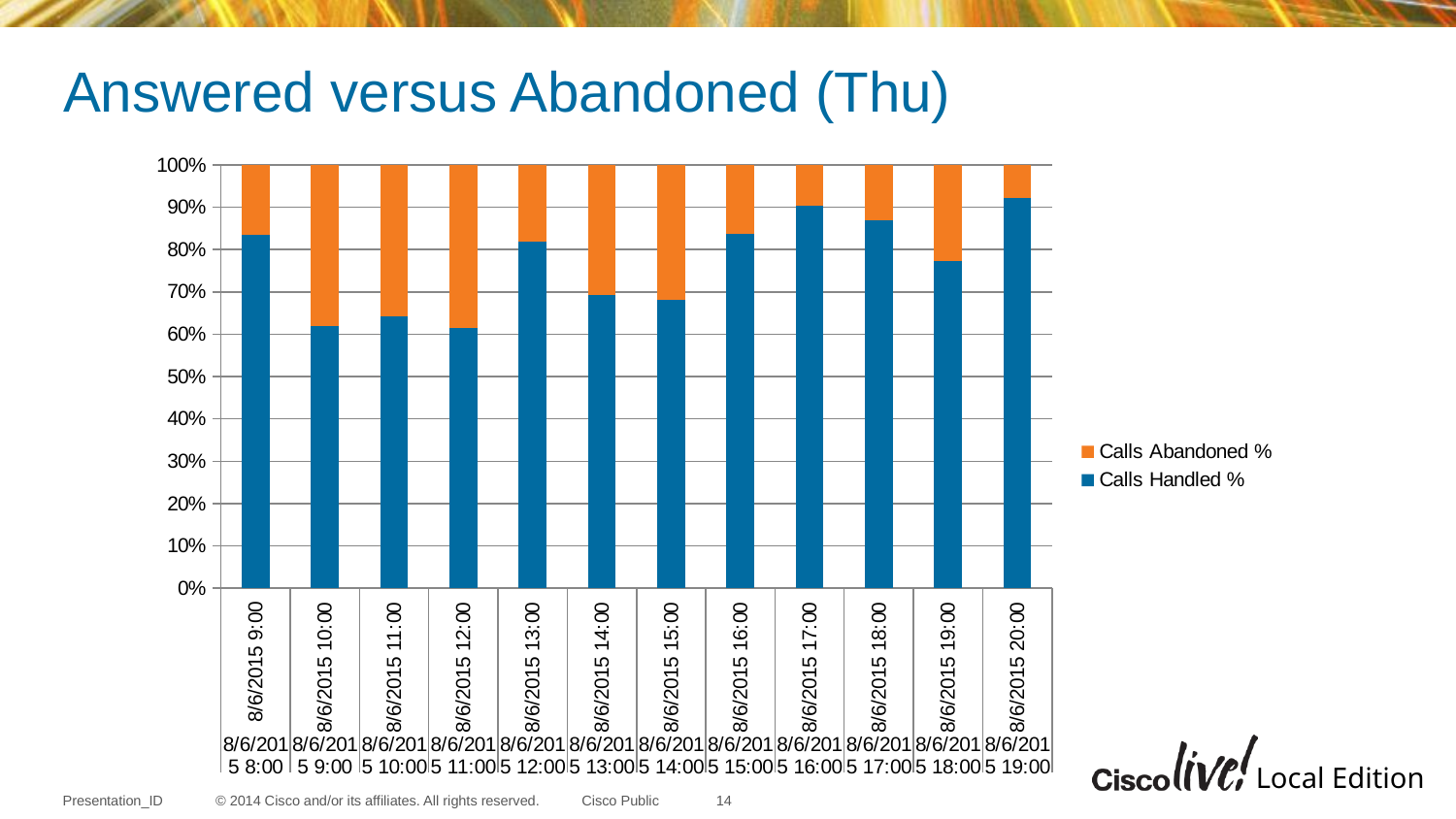
Is the Calls Handled % for the bar labelled 8/6/2015 19:00 greater or less than 80%? less Is the Calls Handled % for the leftmost bar (8/6/2015 9:00) greater or less than 80%? greater Which colour represents Calls Handled % in the chart? Blue Which has the larger Calls Handled %: the leftmost bar (8/6/2015 9:00) or the second bar (8/6/2015 10:00)? 8/6/2015 9:00 Is the Calls Handled % for the rightmost bar (8/6/2015 20:00) greater or less than 90%? greater How many bars (time periods) are plotted in the chart? 12 Which has the larger Calls Abandoned %: the bar labelled 8/6/2015 12:00 or the bar labelled 8/6/2015 17:00? 8/6/2015 12:00 How many series does the legend list? 2 What kind of chart is shown on the slide? Stacked bar chart What are the two series named in the legend? Calls Abandoned % and Calls Handled %